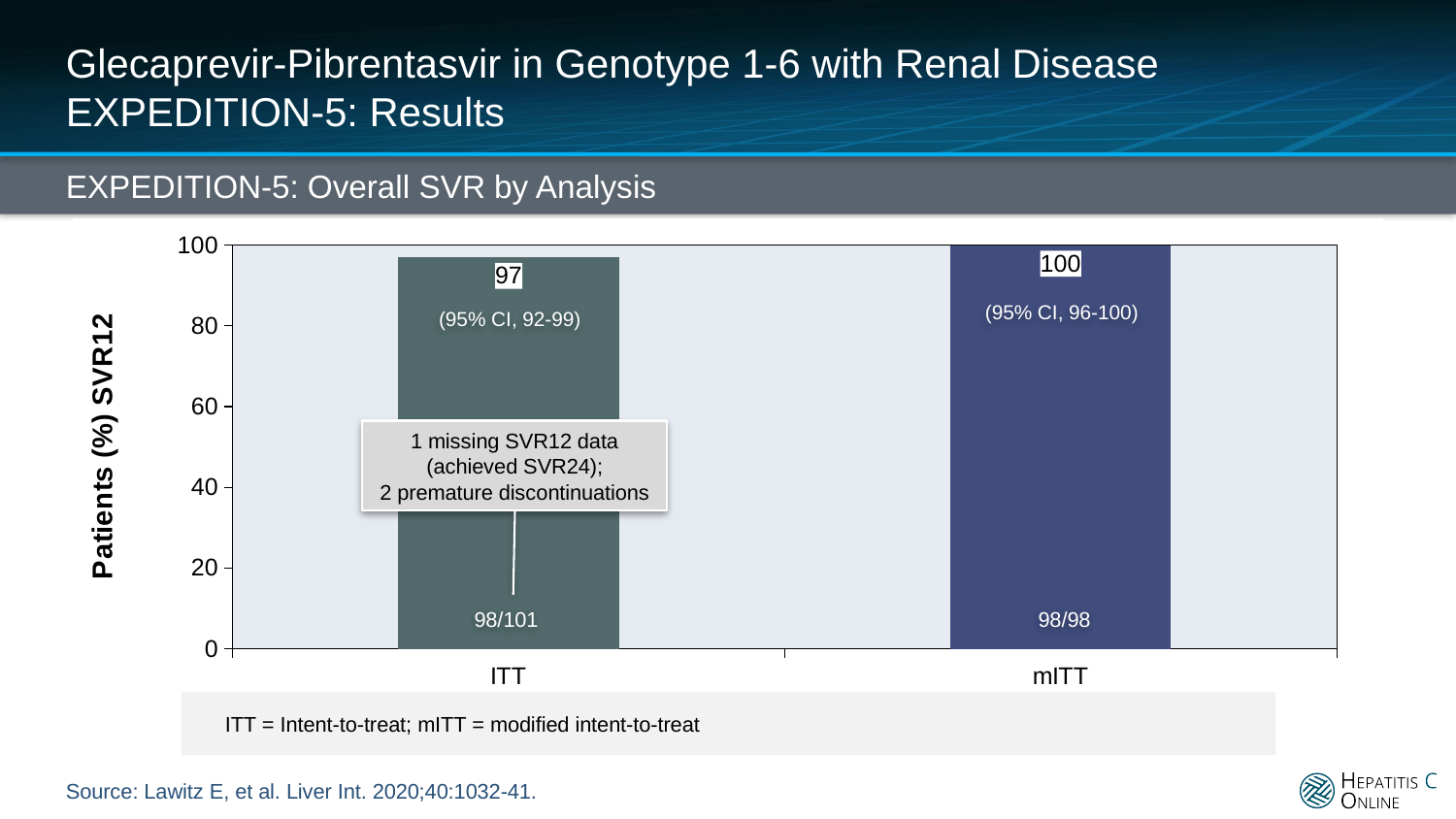
How many analysis groups are shown on the x axis? 2 What is the SVR12 rate (%) for the ITT analysis? 97 What is the SVR12 rate (%) for the mITT analysis? 100 Is the SVR12 rate for ITT greater or less than 80? greater What is the fraction of patients achieving SVR12 shown on the ITT bar? 98/101 What kind of chart is shown on the slide? Bar chart Which analysis group has the lower SVR12 rate? ITT What is the difference in SVR12 rate (percentage points) between mITT and ITT? 3 Which analysis group has the higher SVR12 rate? mITT What is the label of the y axis? Patients (%) SVR12 What is the 95% confidence interval shown for the ITT SVR12 rate? 92-99 What is the fraction of patients achieving SVR12 shown on the mITT bar? 98/98